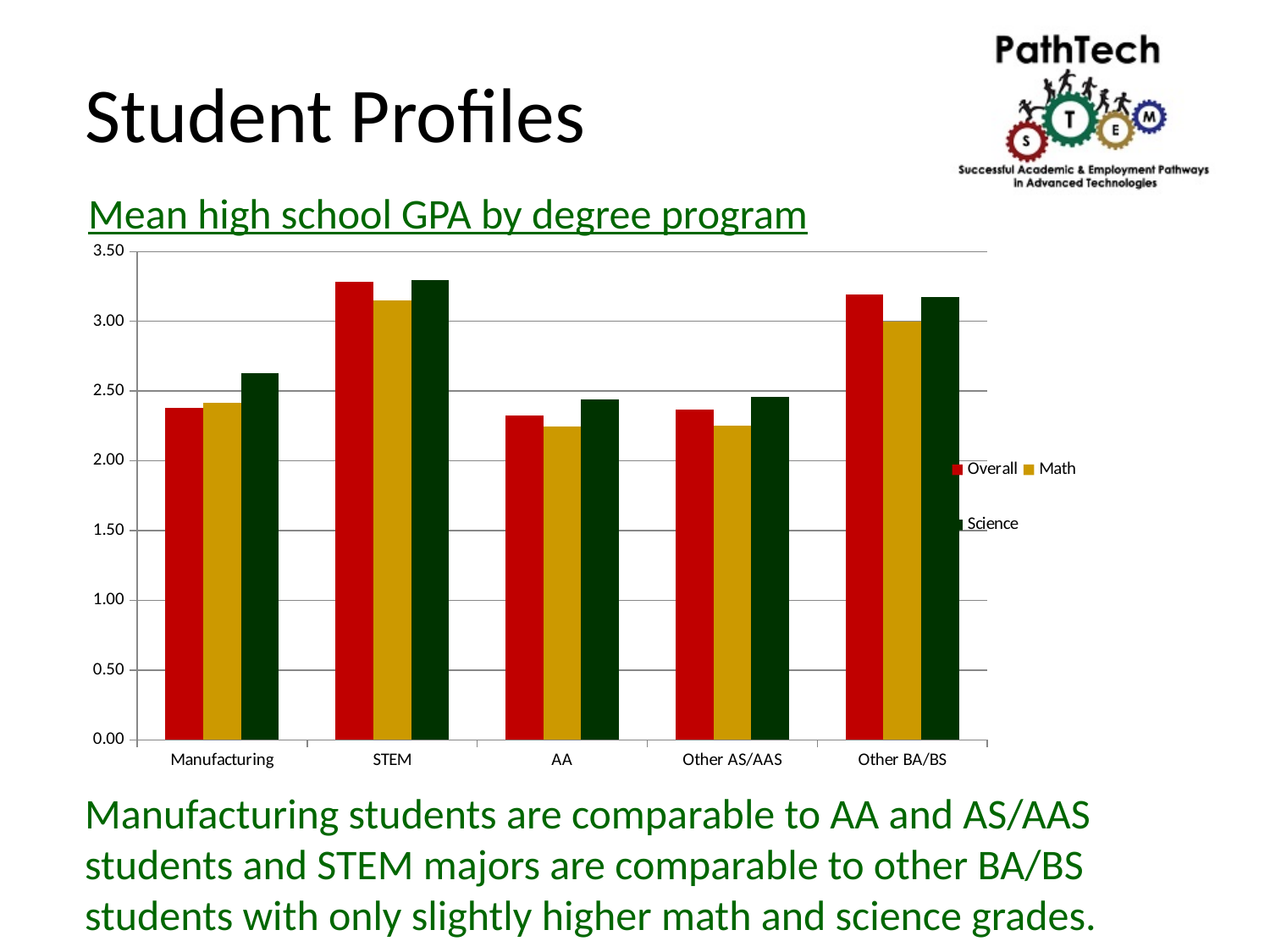
Is the Science value for Manufacturing greater or less than 2.50? greater What is the title of the chart? Mean high school GPA by degree program What kind of chart is shown on the slide? Bar chart For Manufacturing, which is larger: the Overall value or the Science value? Science How many series does the legend list? 3 How many degree program categories are shown on the x axis? 5 Which degree program has the highest Science value? STEM Which degree program has the highest Math value? STEM Is the Math value for AA greater or less than 2.50? less Is the Overall value for Other BA/BS greater or less than 3.00? greater Which series is shown in dark green? Science